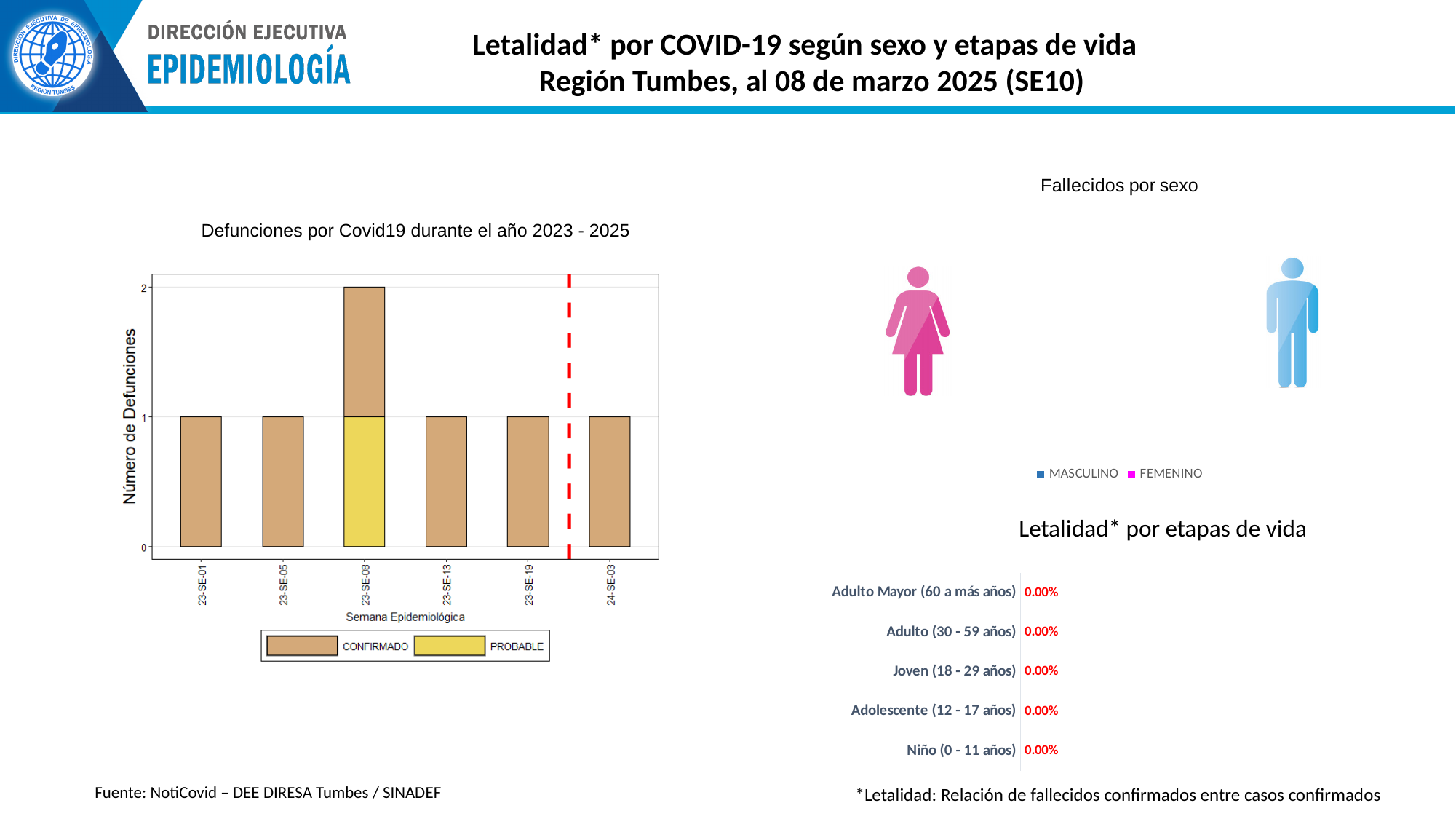
In the chart 'Defunciones por Covid19 durante el año 2023 - 2025', how many confirmed (CONFIRMADO) deaths are shown for week 23-SE-01? 1 In the chart 'Defunciones por Covid19 durante el año 2023 - 2025', what kind of chart is shown? Bar chart In the chart 'Letalidad* por etapas de vida', what is the value for Adulto Mayor (60 a más años)? 0.00% In the chart 'Defunciones por Covid19 durante el año 2023 - 2025', what is the total number of deaths for week 23-SE-08? 2 In the chart 'Defunciones por Covid19 durante el año 2023 - 2025', what is the label of the x axis? Semana Epidemiológica In the chart 'Letalidad* por etapas de vida', how many life-stage categories are listed? 5 In the chart 'Defunciones por Covid19 durante el año 2023 - 2025', how many probable (PROBABLE) deaths are shown for week 23-SE-08? 1 In the chart 'Defunciones por Covid19 durante el año 2023 - 2025', which week is the only one with a PROBABLE death? 23-SE-08 In the chart 'Defunciones por Covid19 durante el año 2023 - 2025', how many series does the legend list? 2 In the chart 'Defunciones por Covid19 durante el año 2023 - 2025', how many epidemiological weeks are shown on the x axis? 6 In the chart 'Defunciones por Covid19 durante el año 2023 - 2025', which week has the highest total number of deaths? 23-SE-08 In the chart 'Defunciones por Covid19 durante el año 2023 - 2025', what is the difference between the total deaths in week 23-SE-08 and week 24-SE-03? 1